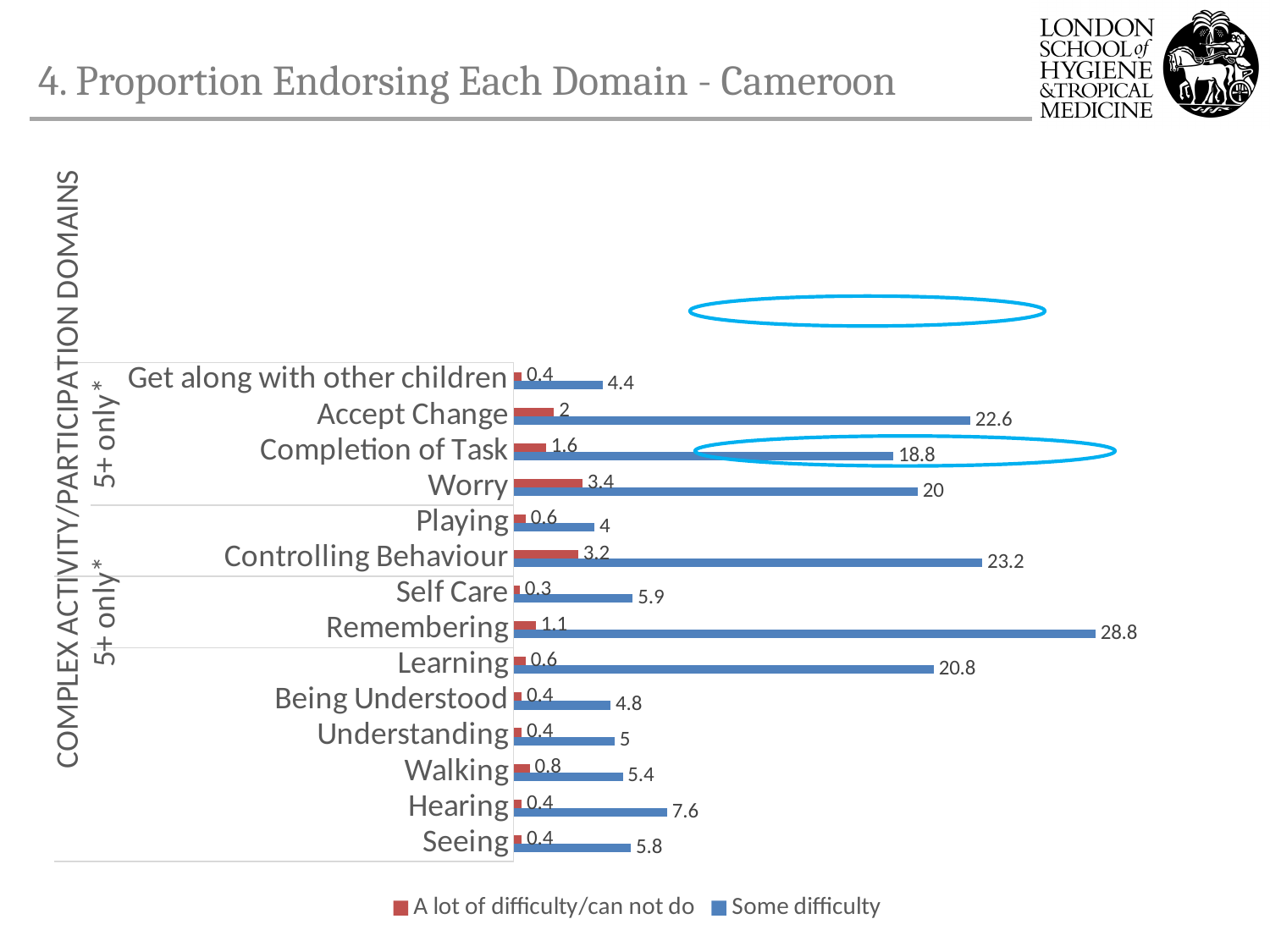
Which domain has the lowest 'A lot of difficulty/can not do' value? Self Care What is the 'A lot of difficulty/can not do' value for Worry? 3.4 What type of chart is shown on the slide? bar chart How many series does the legend list? 2 Which has a larger 'Some difficulty' value, Hearing or Seeing? Hearing Which series is shown in red in the legend? A lot of difficulty/can not do Which domain has the lowest 'Some difficulty' value? Playing Which domain has the highest 'Some difficulty' value? Remembering What is the 'Some difficulty' value for Completion of Task? 18.8 What is the difference between the 'Some difficulty' values for Controlling Behaviour and Accept Change? 0.6 What is the 'Some difficulty' value for Remembering? 28.8 How many domains (categories) are plotted in the chart? 14